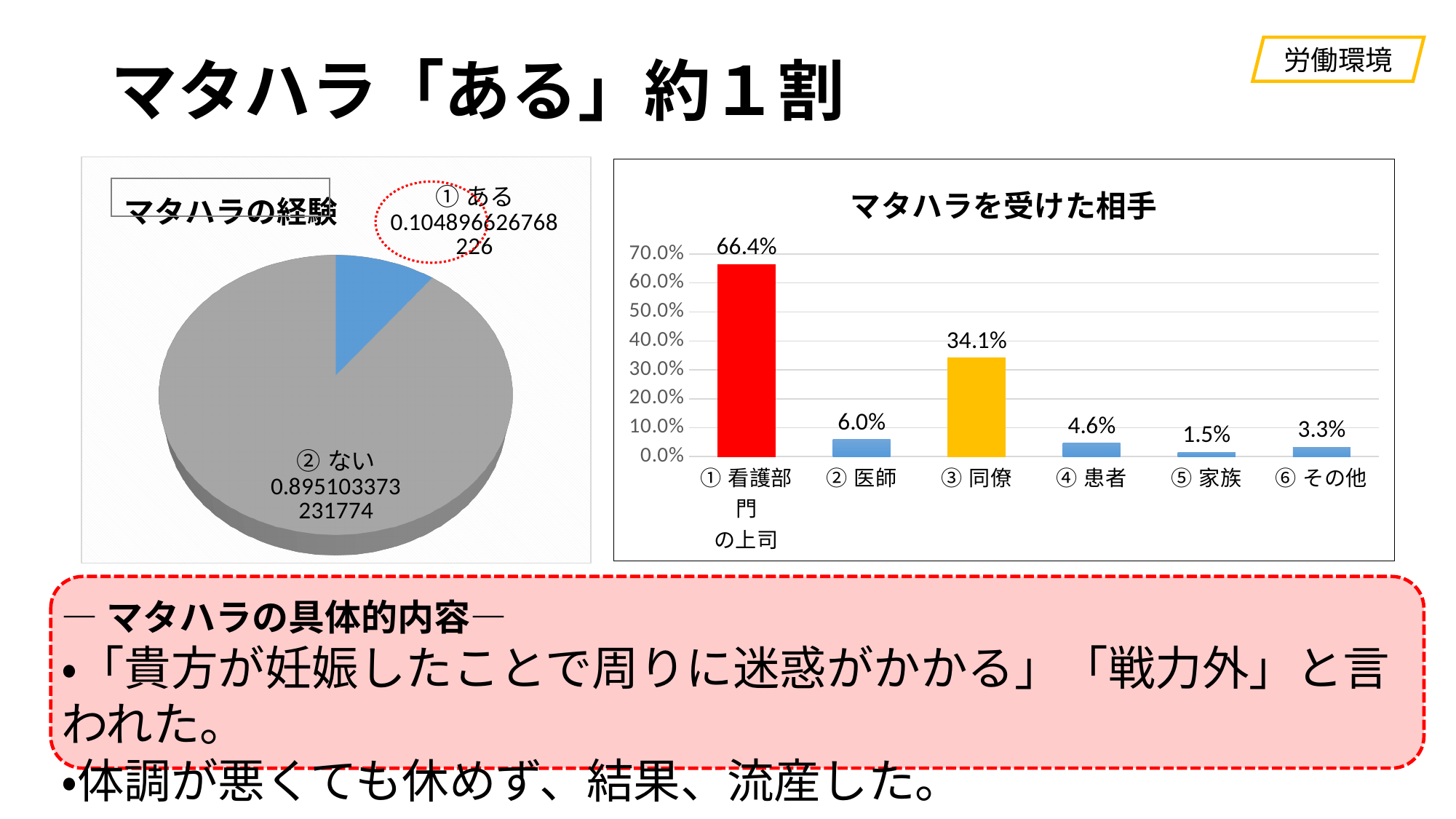
In the pie chart titled マタハラの経験, what value is shown for ① ある? 0.104896626768226 In the bar chart titled マタハラを受けた相手, what is the difference between the values for ① 看護部門の上司 and ③ 同僚? 32.3% What kind of chart is the chart titled マタハラを受けた相手? Bar chart What kind of chart is the chart titled マタハラの経験? Pie chart In the bar chart titled マタハラを受けた相手, what is the value for ③ 同僚? 34.1% In the bar chart titled マタハラを受けた相手, what is the value for ① 看護部門の上司? 66.4% In the bar chart titled マタハラを受けた相手, which category has the highest value? ① 看護部門の上司 In the bar chart titled マタハラを受けた相手, how many categories are shown? 6 In the bar chart titled マタハラを受けた相手, which is larger, the value for ② 医師 or the value for ④ 患者? ② 医師 In the bar chart titled マタハラを受けた相手, what is the value for ⑤ 家族? 1.5% In the bar chart titled マタハラを受けた相手, which category has the lowest value? ⑤ 家族 In the pie chart titled マタハラの経験, which slice is larger, ① ある or ② ない? ② ない